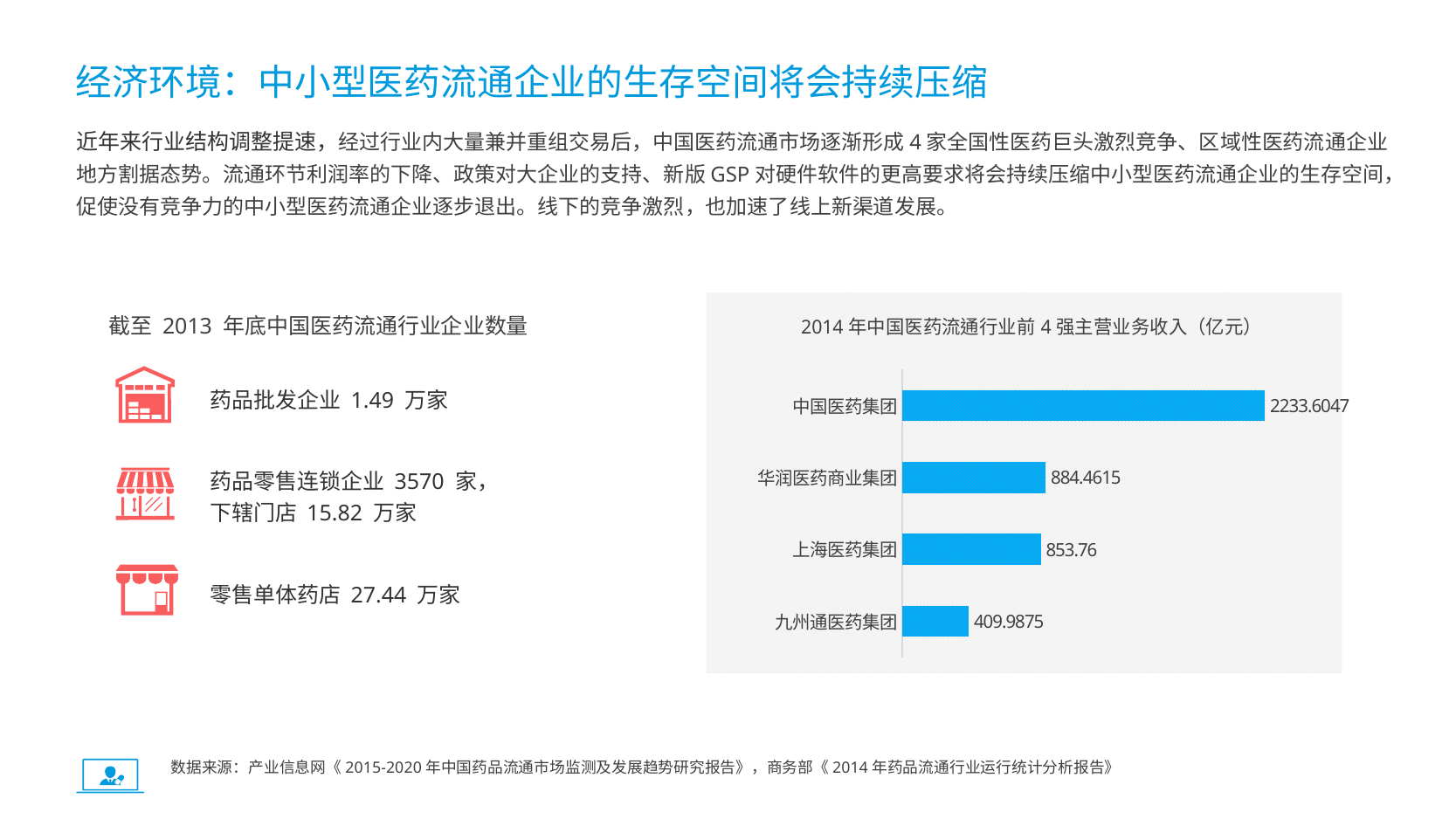
Which has a larger main business revenue, 华润医药商业集团 or 上海医药集团? 华润医药商业集团 What is the difference between the revenue of 中国医药集团 and 华润医药商业集团? 1349.1432 Which company has the lowest main business revenue in the chart? 九州通医药集团 What is the main business revenue of 九州通医药集团 in the chart? 409.9875 What is the difference between the revenue of 上海医药集团 and 九州通医药集团? 443.7725 What is the main business revenue of 上海医药集团 in the chart? 853.76 What is the main business revenue of 华润医药商业集团 in the chart? 884.4615 What type of chart is shown on the slide? bar chart What is the main business revenue of 中国医药集团 in the chart? 2233.6047 What is the title of the chart? 2014 年中国医药流通行业前 4 强主营业务收入（亿元） How many companies are shown in the chart? 4 Which company has the highest main business revenue in the chart? 中国医药集团